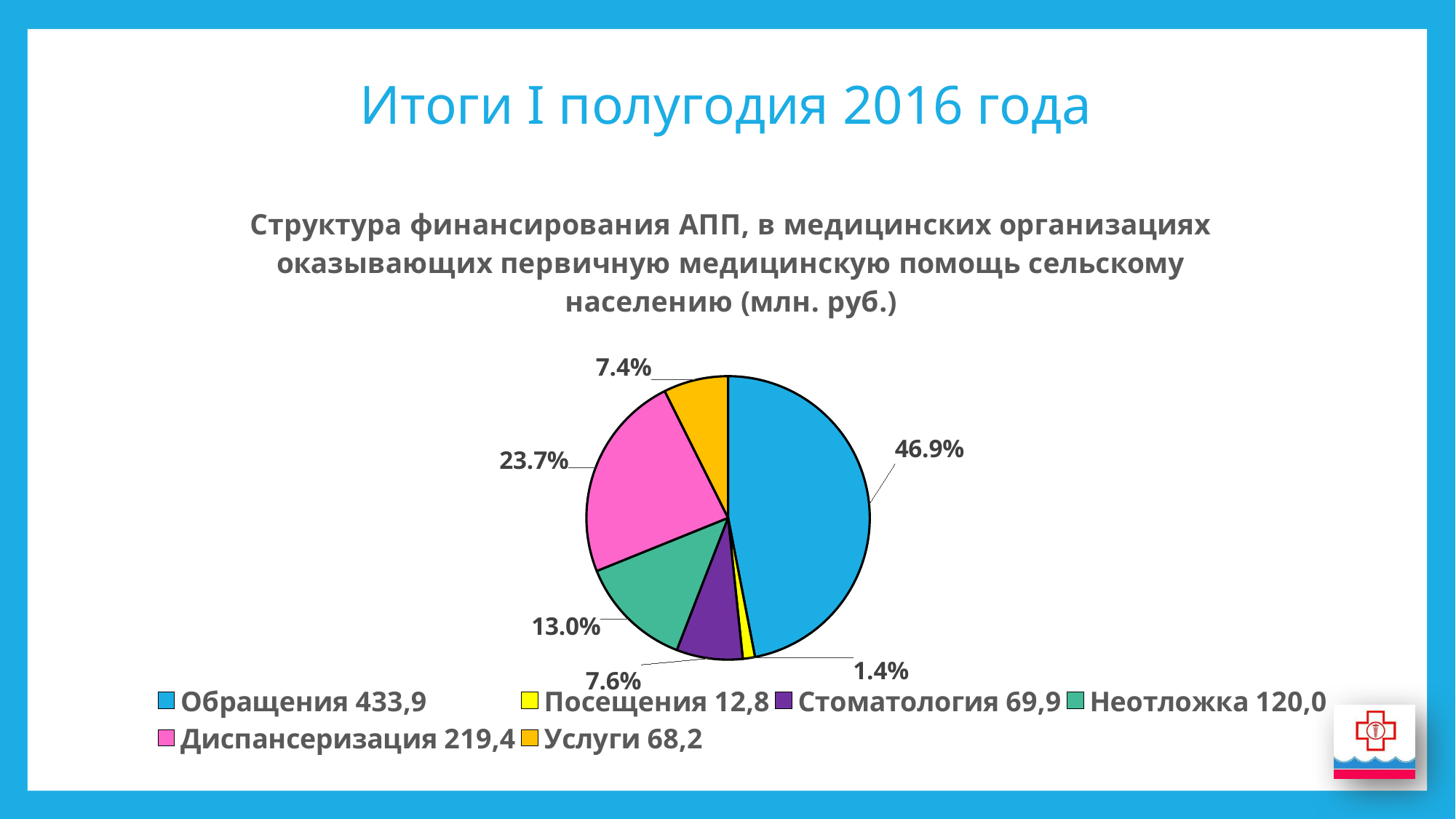
What value (млн. руб.) is shown in the legend for Услуги? 68,2 What share of the pie does Обращения take? 46.9% Which category has the largest slice of the pie? Обращения What share of the pie does Диспансеризация take? 23.7% What value (млн. руб.) is shown in the legend for Стоматология? 69,9 What kind of chart is shown on the slide? pie chart What share of the pie does Посещения take? 1.4% What colour is the slice for Диспансеризация? pink Which category has the smallest slice of the pie? Посещения How many slices does the pie chart have? 6 Which is larger, the slice for Неотложка or the slice for Стоматология? Неотложка